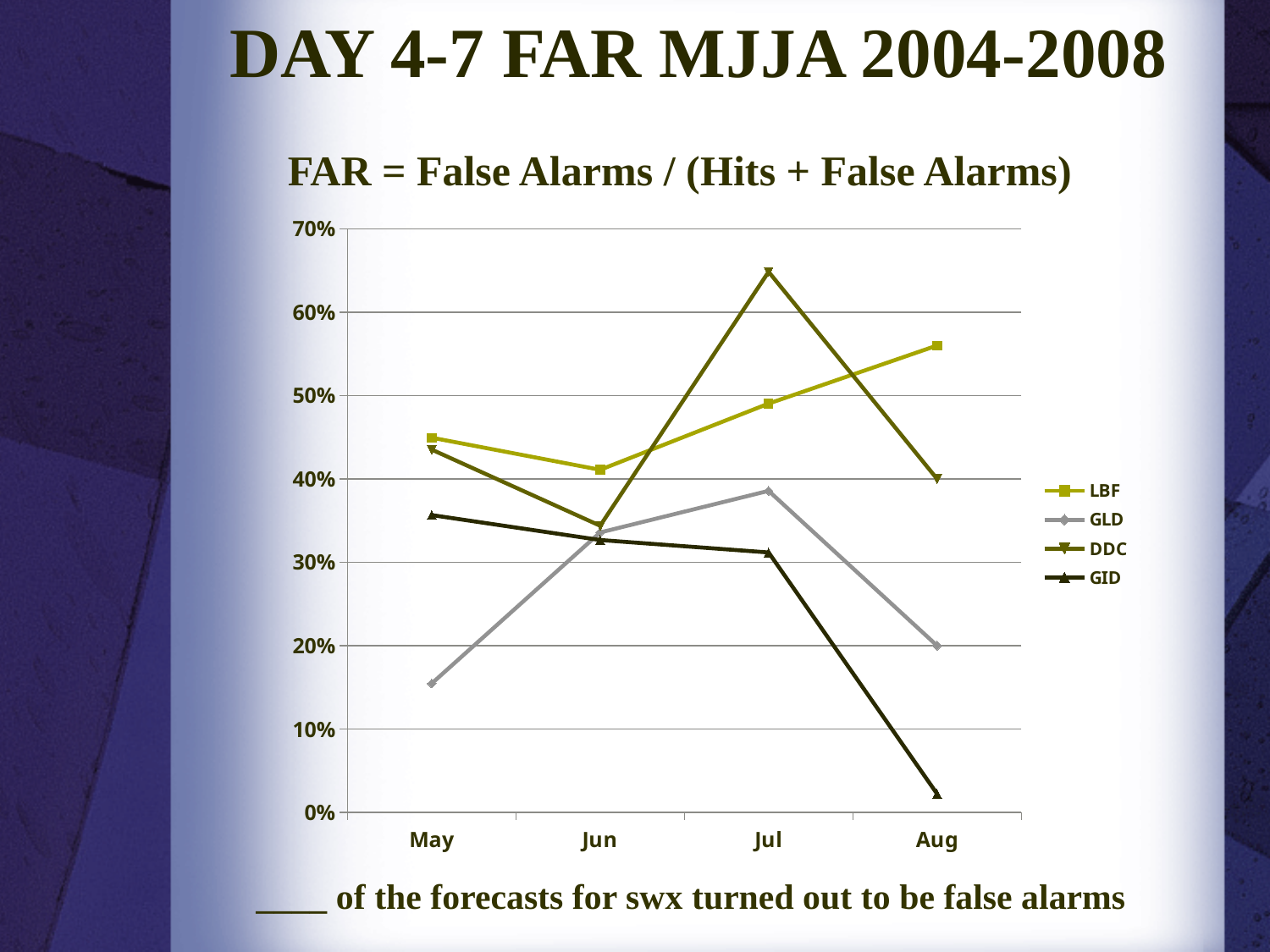
What kind of chart is shown on the slide? line chart Which series has the lowest value in Aug? GID In May, which is larger, the value for LBF or the value for GLD? LBF Which series has the highest value in Jul? DDC Is the value for GLD in May greater or less than 20%? less How many series does the legend list? 4 Which series has the highest value in Aug? LBF Does the GID series rise or fall from May to Aug? fall Is the value for GID in Aug greater or less than 10%? less In which month is the GID series at its lowest? Aug How many months are shown on the x axis? 4 Is the value for DDC in Jul greater or less than 60%? greater